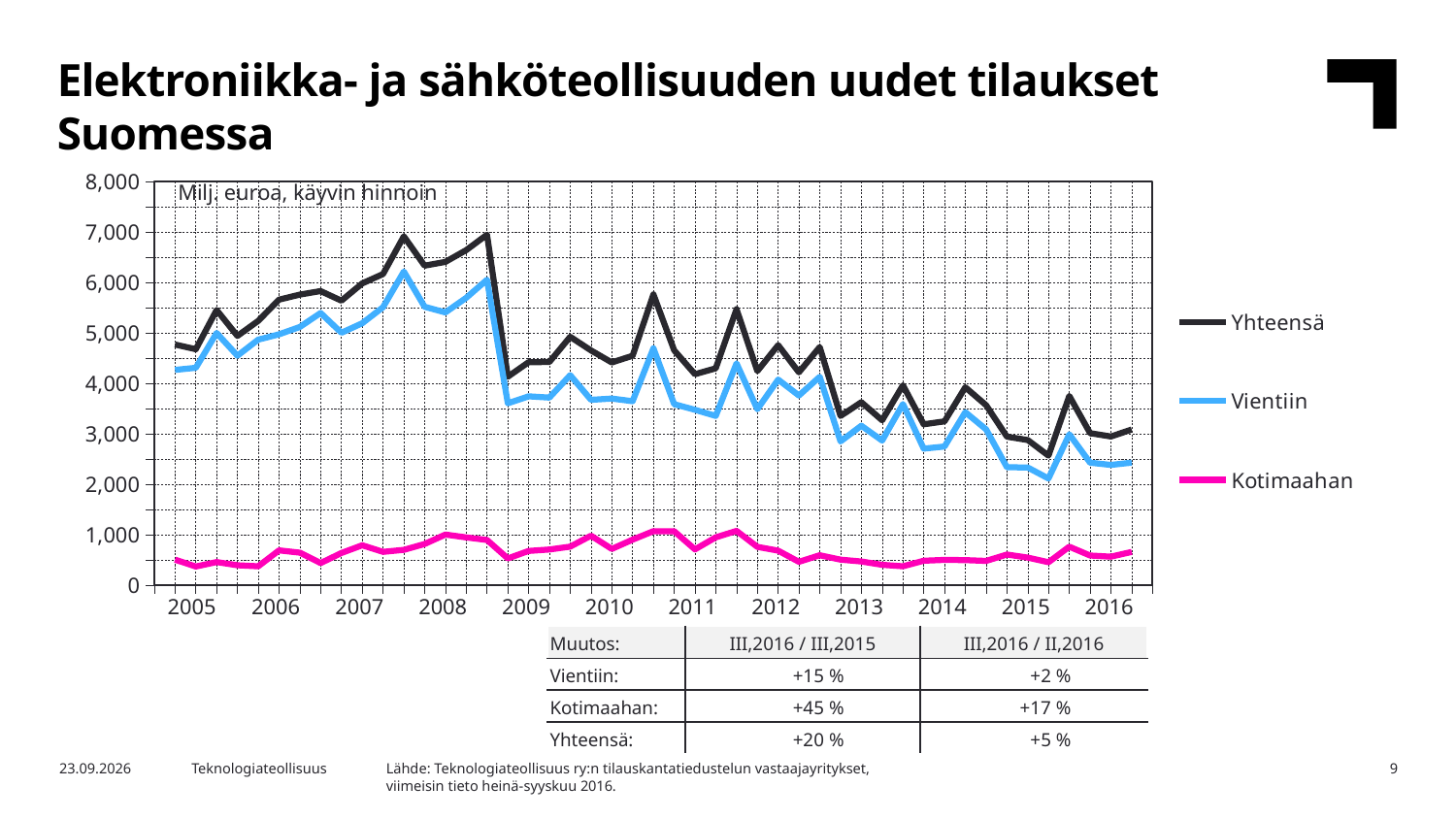
Is the value for Kotimaahan in 2005 greater or less than 1,000? less What kind of chart is shown on the slide? line chart How many series does the legend list? 3 In 2010, which is larger: the value for Yhteensä or the value for Kotimaahan? Yhteensä Which series has the lowest values across the whole period? Kotimaahan What unit label is shown inside the chart area? Milj. euroa, käyvin hinnoin Do the values for Yhteensä rise or fall from 2008 to 2016? fall How many years are labelled on the x axis? 12 Is the peak value for Yhteensä in 2008 greater or less than 6,000? greater Which series has the highest values across the whole period? Yhteensä What are the three series named in the legend? Yhteensä, Vientiin, Kotimaahan Is the value for Vientiin in 2016 greater or less than 3,000? less